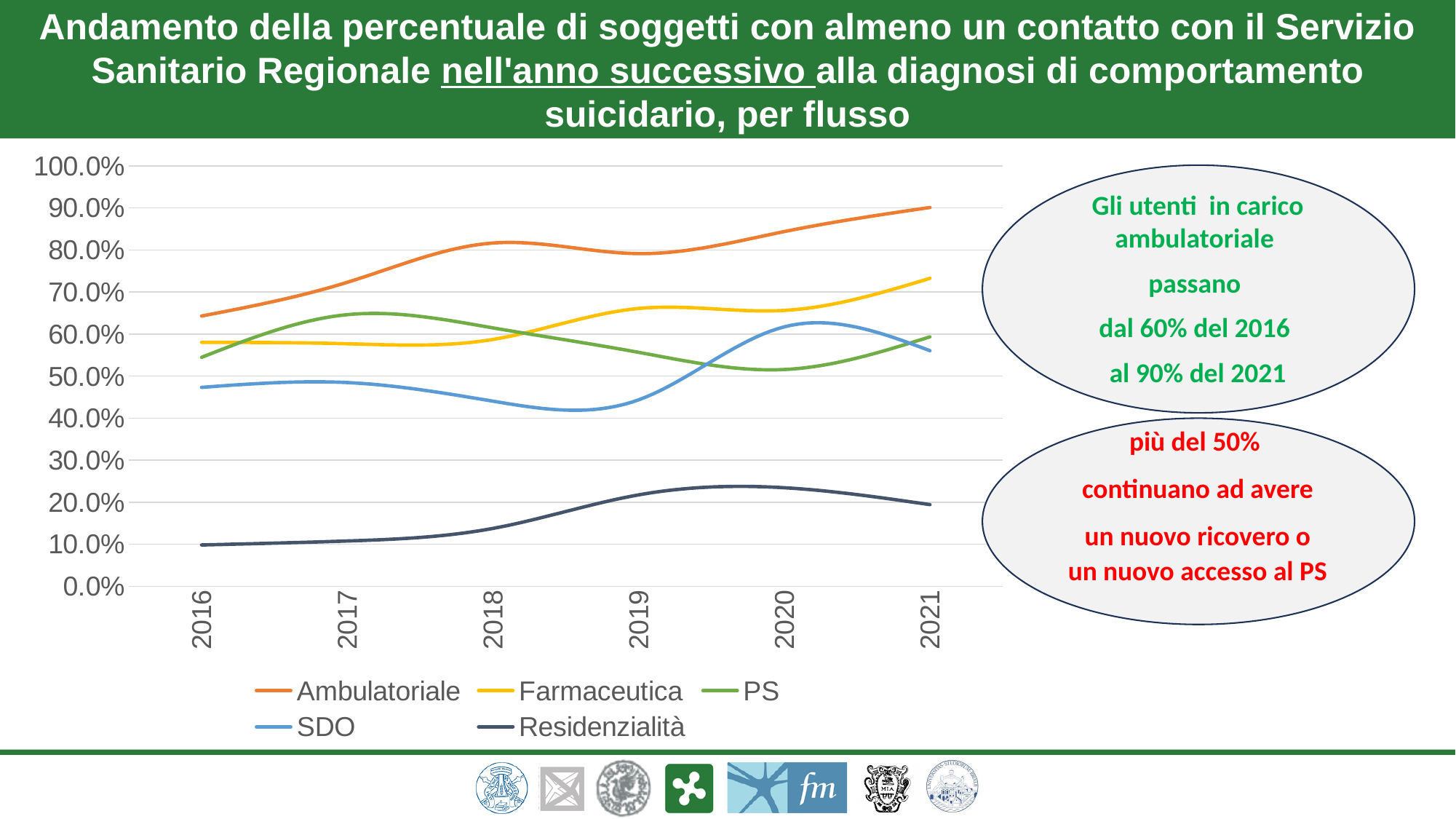
Which series has the highest value in 2021? Ambulatoriale Is the value for Ambulatoriale in 2021 greater or less than 80.0%? greater Is the value for SDO in 2018 greater or less than 50.0%? less Is the value for Farmaceutica in 2021 greater or less than 70.0%? greater How many series does the legend list? 5 Does the Ambulatoriale line rise or fall from 2016 to 2021? rise Which series is drawn in orange? Ambulatoriale How many years are shown on the x axis? 6 What kind of chart is shown on the slide? line chart In 2020, which is larger: SDO or PS? SDO Which series has the lowest value in 2021? Residenzialità